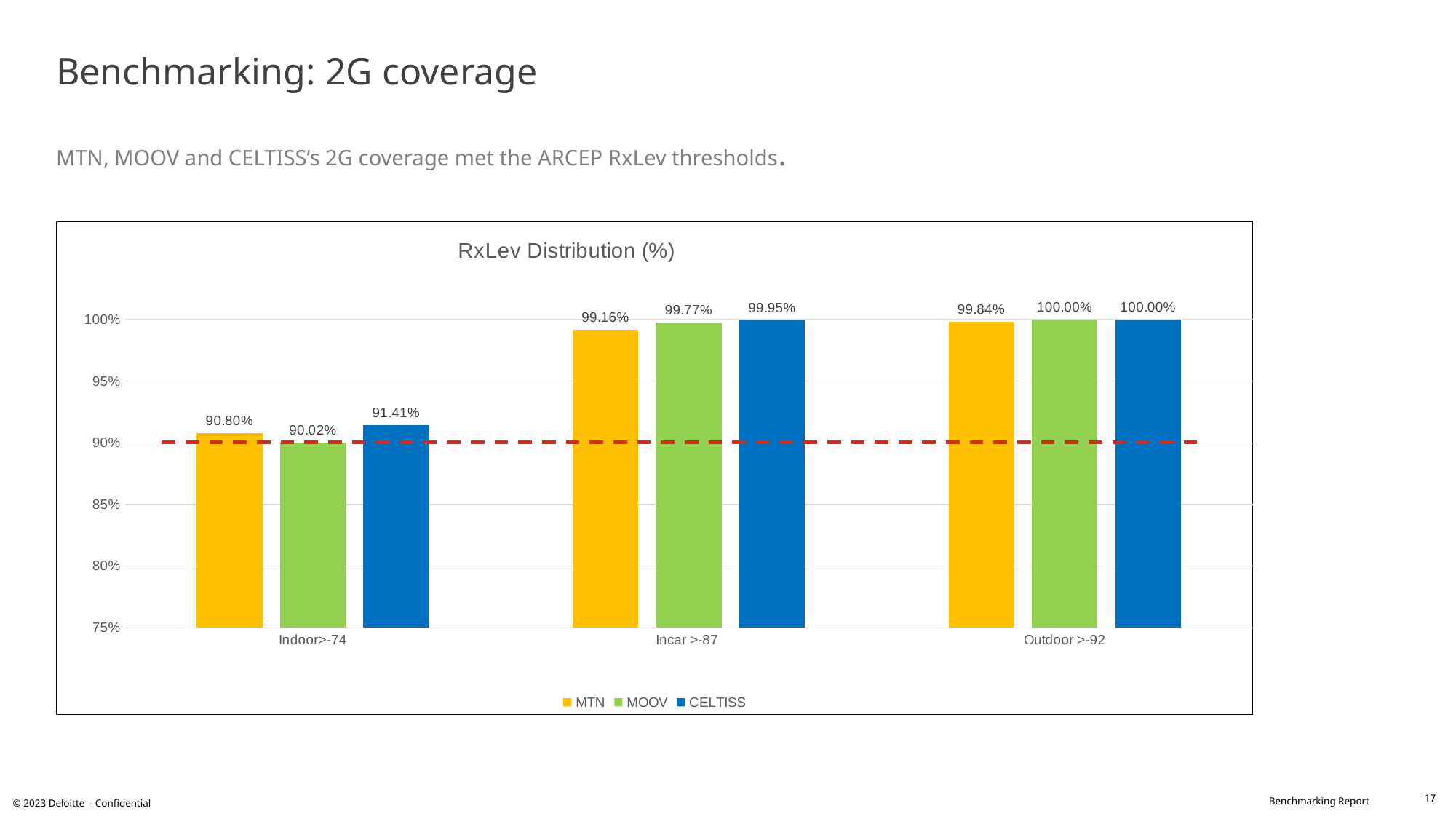
What is the difference between the CELTISS and MOOV values for Indoor>-74? 1.39% How many categories are shown on the x axis? 3 What kind of chart is shown? Bar chart Which is larger for Incar >-87: the MTN value or the MOOV value? MOOV Which operator has the highest value for Incar >-87? CELTISS What is the CELTISS value for Incar >-87? 99.95% Which operator has the lowest value for Indoor>-74? MOOV What is the MOOV value for Outdoor >-92? 100.00% What is the title of the chart? RxLev Distribution (%) What is the MTN value for Indoor>-74? 90.80% Is the MTN value for Incar >-87 greater or less than 95%? greater How many series does the legend list? 3